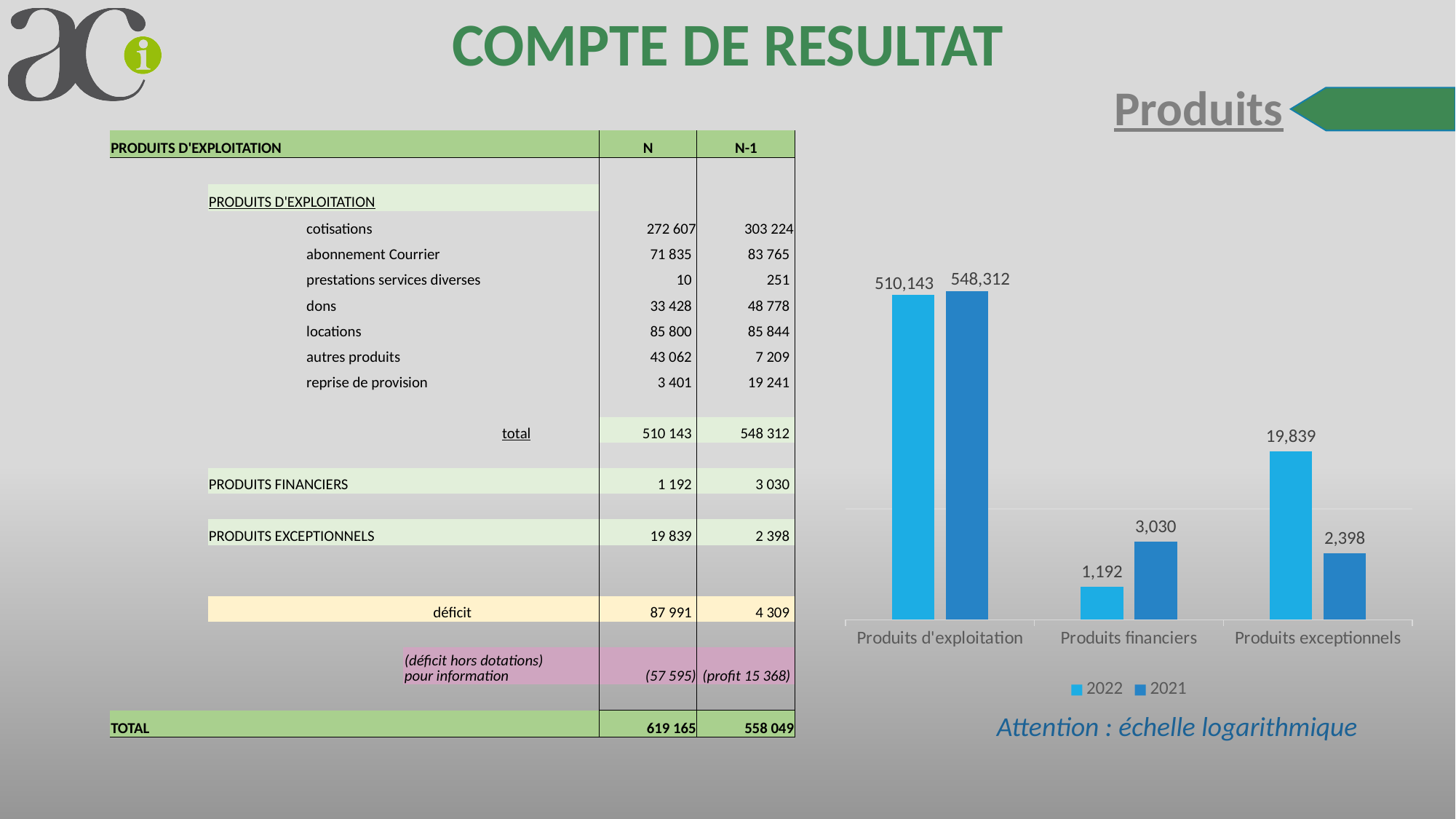
What is the value for Produits financiers in 2021 on the chart? 3,030 What is the difference between the 2022 and 2021 values for Produits exceptionnels on the chart? 17,441 For Produits financiers, which year has the larger value on the chart, 2022 or 2021? 2021 What is the value for Produits d'exploitation in 2022 on the chart? 510,143 For Produits exceptionnels, which year has the larger value on the chart, 2022 or 2021? 2022 How many categories are shown on the x axis of the chart? 3 What is the difference between the 2021 and 2022 values for Produits d'exploitation on the chart? 38,169 How many series does the chart legend list? 2 Which category has the highest 2021 value on the chart? Produits d'exploitation Which category has the lowest 2022 value on the chart? Produits financiers What is the value for Produits exceptionnels in 2022 on the chart? 19,839 What kind of chart is shown on the slide? Bar chart